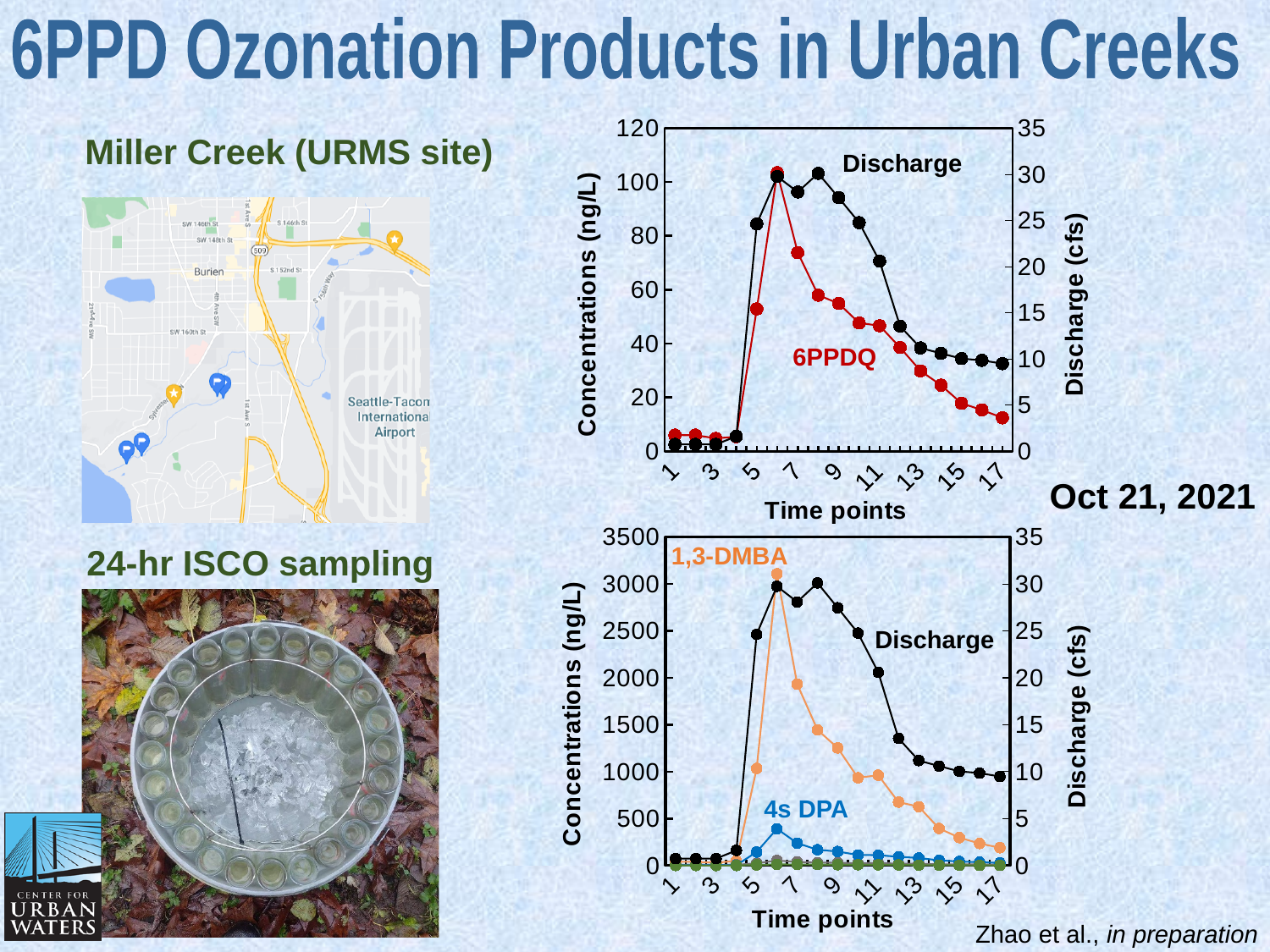
In the top chart, at which time point does the 6PPDQ concentration reach its highest value? 6 In the top chart, is the 6PPDQ concentration at time point 6 greater or less than 80 ng/L? greater In the top chart, how many time points are shown along the x axis? 17 In the top chart, does the 6PPDQ concentration rise or fall from time point 6 to time point 17? fall In the top chart, is the 6PPDQ concentration at time point 17 greater or less than 20 ng/L? less What is the label of the right-hand y axis on the top chart? Discharge (cfs) What kind of chart is the top chart on the slide? line chart In the bottom chart, is the 1,3-DMBA concentration at time point 6 greater or less than 2500 ng/L? greater In the bottom chart, at time point 6, which is larger: the 1,3-DMBA concentration or the 4s DPA concentration? 1,3-DMBA In the bottom chart, at which time point does the 1,3-DMBA concentration reach its highest value? 6